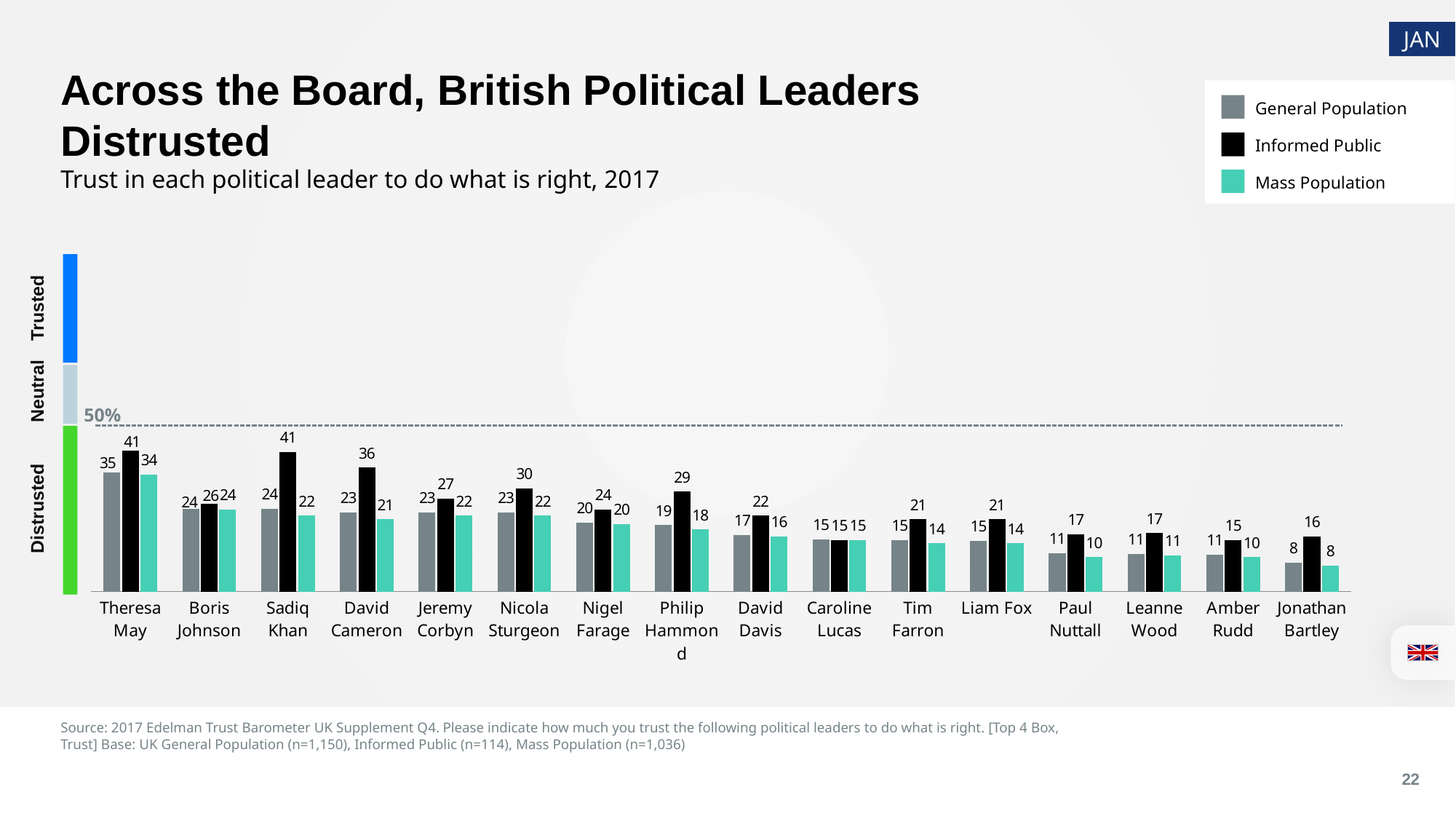
What is the Informed Public value for Sadiq Khan? 41 How many political leaders are shown on the x axis? 16 Which political leader has the lowest Mass Population value? Jonathan Bartley What kind of chart is shown on the slide? bar chart What is the General Population value for Theresa May? 35 Which is larger for Nicola Sturgeon: the Informed Public value or the Mass Population value? Informed Public Which colour represents the Informed Public series in the legend? black What is the difference between the Informed Public and General Population values for David Cameron? 13 How many series does the legend list? 3 Is the Informed Public value for Theresa May greater or less than 50%? less Which political leader has the highest General Population value? Theresa May What is the Mass Population value for Philip Hammond? 18